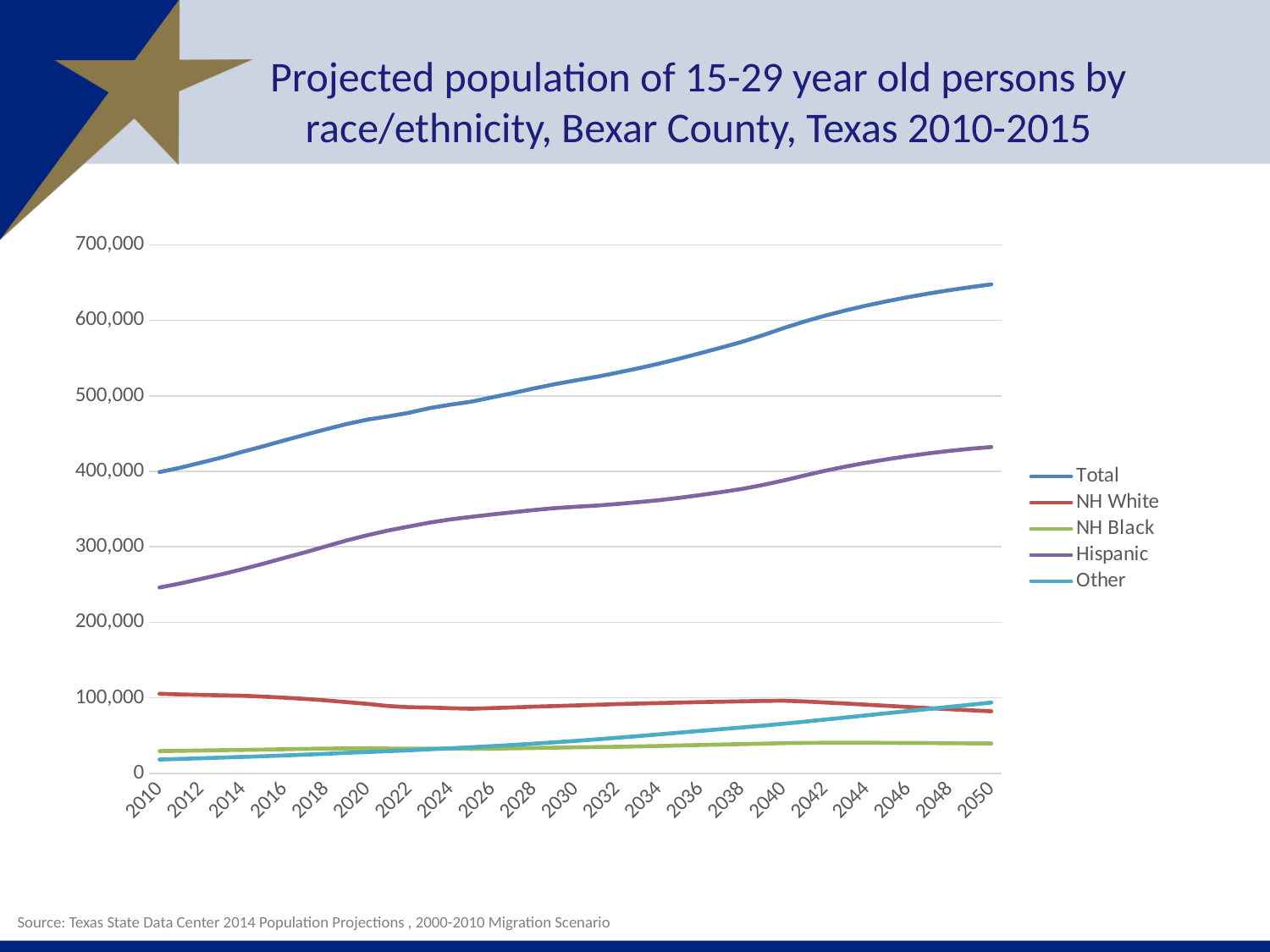
In 2010, which is larger: NH Black or Other? NH Black Which series has the highest value in 2050? Total Is the value for Hispanic in 2010 greater or less than 300,000? less How many series does the legend list? 5 What kind of chart is shown on the slide? Line chart Does the NH White line rise or fall from 2010 to 2050? Falls Is the value for Hispanic in 2050 greater or less than 400,000? greater How many years are labelled along the x axis? 21 Is the value for Total in 2050 greater or less than 600,000? greater Which series has the lowest value in 2010? Other What is the title of the chart? Projected population of 15-29 year old persons by race/ethnicity, Bexar County, Texas 2010-2015 Does the Total line rise or fall from 2010 to 2050? Rises